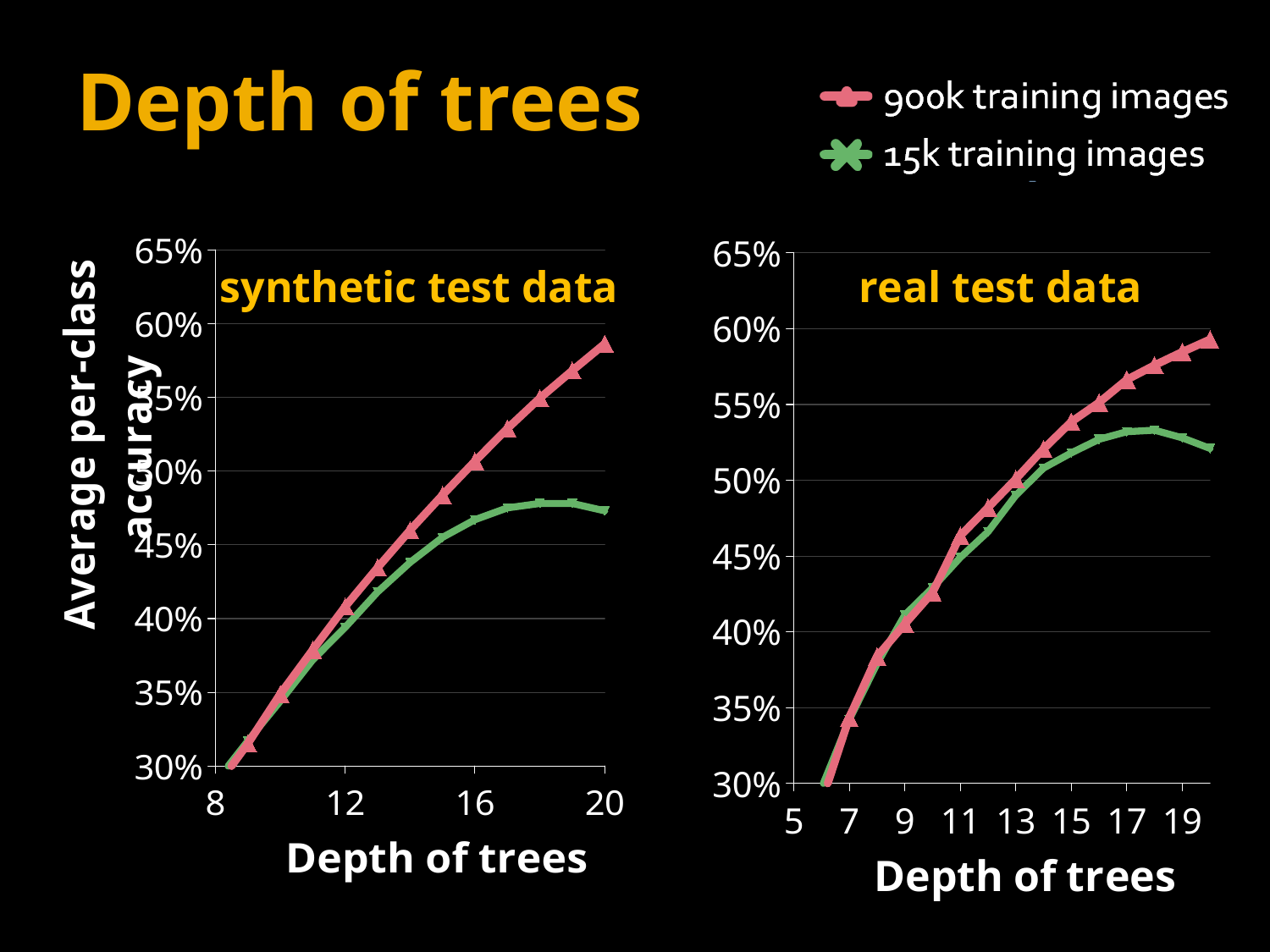
In the 'synthetic test data' chart, is the value for 900k training images at depth 20 greater or less than 55%? greater Which series is drawn in green? 15k training images In the 'real test data' chart, is the value for 900k training images at depth 19 greater or less than 55%? greater In the 'real test data' chart, which series has the higher value at depth 19? 900k training images In the 'synthetic test data' chart, does the 900k training images series rise or fall as depth of trees increases? rise How many series does the legend list? 2 In the 'real test data' chart, does the 900k training images series rise or fall as depth of trees increases? rise In the 'synthetic test data' chart, is the value for 15k training images at depth 20 greater or less than 50%? less What kind of chart is the 'synthetic test data' chart? line chart What is the x-axis label of the 'real test data' chart? Depth of trees In the 'synthetic test data' chart, which series has the higher value at depth 20? 900k training images